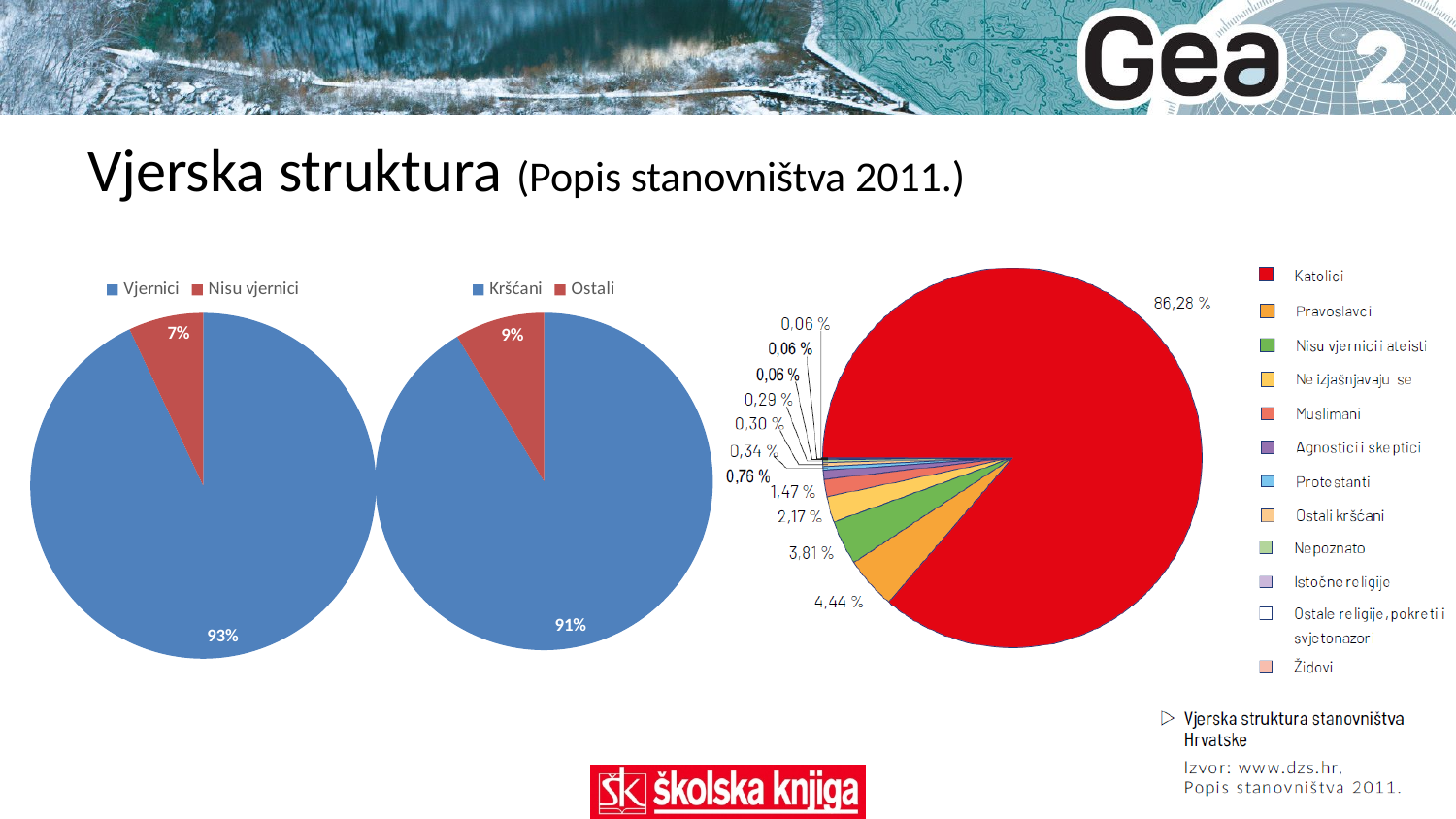
What type of chart is the middle chart (Kršćani / Ostali)? Pie chart In the middle pie chart (Kršćani / Ostali), which category has the smaller share? Ostali In the right pie chart (Vjerska struktura stanovništva Hrvatske), what colour is the Katolici slice? Red In the right pie chart (Vjerska struktura stanovništva Hrvatske), what percentage is shown for Katolici? 86,28 % In the left pie chart (Vjernici / Nisu vjernici), what is the difference in percentage points between Vjernici and Nisu vjernici? 86 In the left pie chart (Vjernici / Nisu vjernici), what percentage is shown for Nisu vjernici? 7% In the left pie chart (Vjernici / Nisu vjernici), which category has the larger share? Vjernici In the right pie chart (Vjerska struktura stanovništva Hrvatske), how many categories does the legend list? 12 In the middle pie chart (Kršćani / Ostali), what percentage is shown for Ostali? 9% In the middle pie chart (Kršćani / Ostali), what percentage is shown for Kršćani? 91% In the right pie chart (Vjerska struktura stanovništva Hrvatske), which category has the largest share? Katolici In the left pie chart (Vjernici / Nisu vjernici), what percentage is shown for Vjernici? 93%